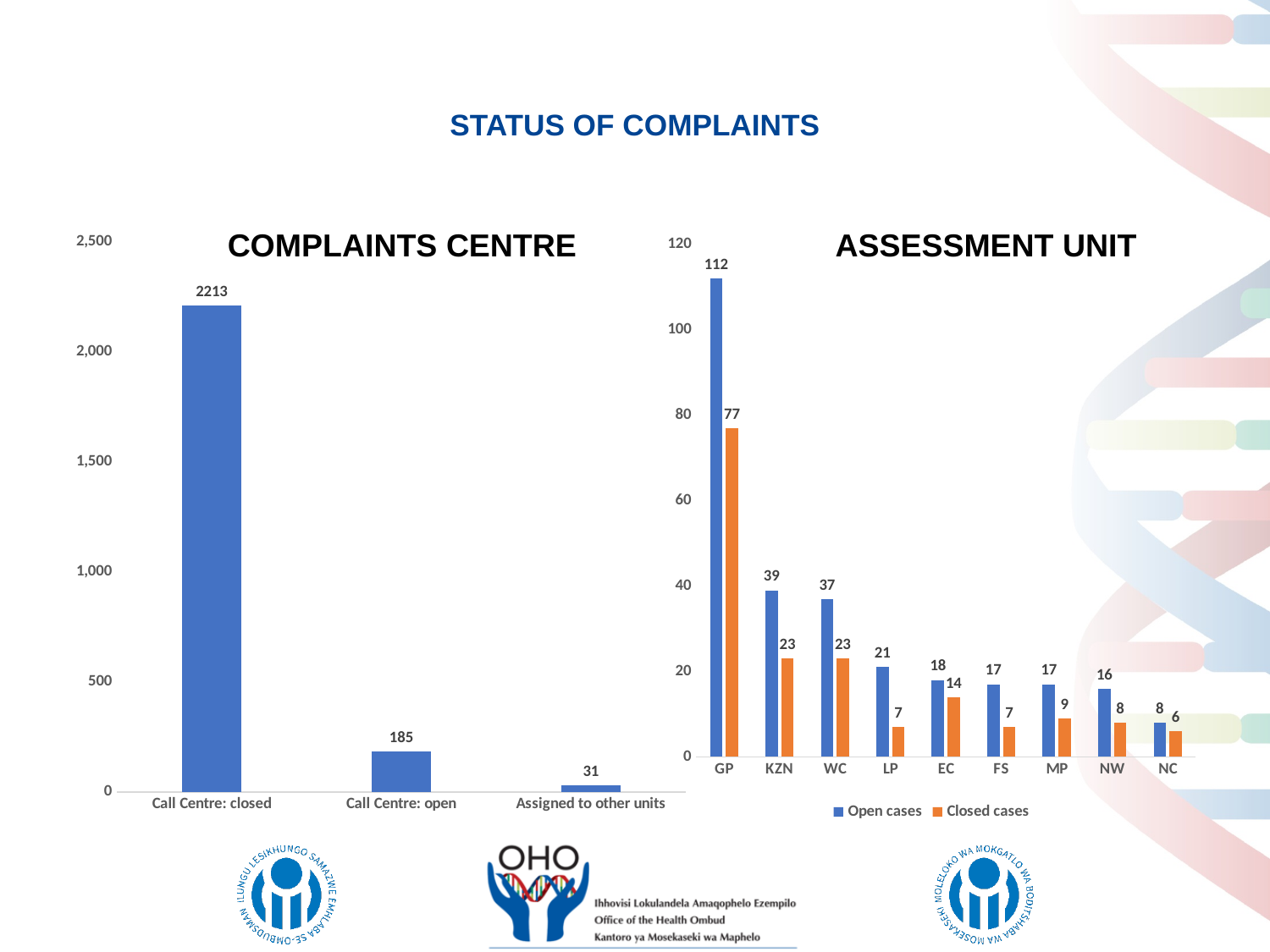
In the COMPLAINTS CENTRE chart, which category has the lowest value? Assigned to other units In the ASSESSMENT UNIT chart, what is the value of Closed cases for LP? 7 In the ASSESSMENT UNIT chart, what is the difference between Open cases and Closed cases for KZN? 16 In the COMPLAINTS CENTRE chart, how many categories are shown on the x axis? 3 In the ASSESSMENT UNIT chart, which is larger for EC: Open cases or Closed cases? Open cases In the ASSESSMENT UNIT chart, what is the value of Open cases for GP? 112 What kind of chart is the ASSESSMENT UNIT chart? Bar chart In the COMPLAINTS CENTRE chart, what is the difference between Call Centre: closed and Call Centre: open? 2028 In the COMPLAINTS CENTRE chart, what is the value for Assigned to other units? 31 In the COMPLAINTS CENTRE chart, what is the value for Call Centre: closed? 2213 In the ASSESSMENT UNIT chart, which province has the lowest number of Closed cases? NC In the ASSESSMENT UNIT chart, how many series does the legend list? 2